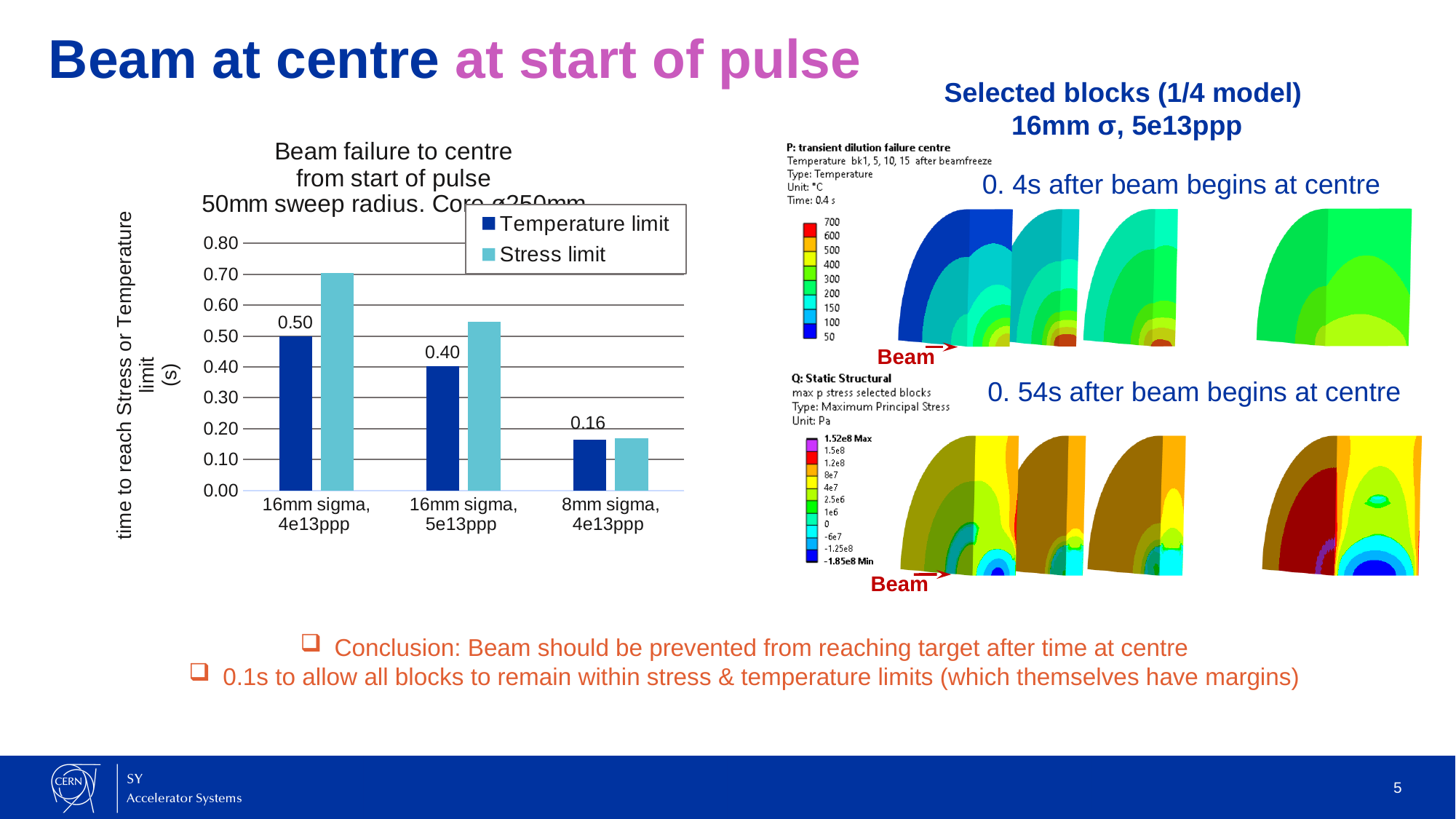
Which category has the highest Temperature limit value? 16mm sigma, 4e13ppp What is the difference between the Temperature limit values for 16mm sigma, 4e13ppp and 16mm sigma, 5e13ppp? 0.10 Do the Temperature limit values rise or fall from left to right across the categories? fall How many categories are shown on the x axis of the bar chart? 3 What is the Temperature limit value for 16mm sigma, 4e13ppp? 0.50 What is the Temperature limit value for 16mm sigma, 5e13ppp? 0.40 Which category has the larger Stress limit value: 16mm sigma, 4e13ppp or 16mm sigma, 5e13ppp? 16mm sigma, 4e13ppp Which category has the lowest Temperature limit value? 8mm sigma, 4e13ppp How many series does the legend of the bar chart list? 2 What kind of chart is used to show the time to reach stress or temperature limit? bar chart What is the Temperature limit value for 8mm sigma, 4e13ppp? 0.16 Is the Stress limit value for 16mm sigma, 4e13ppp greater or less than 0.60? greater